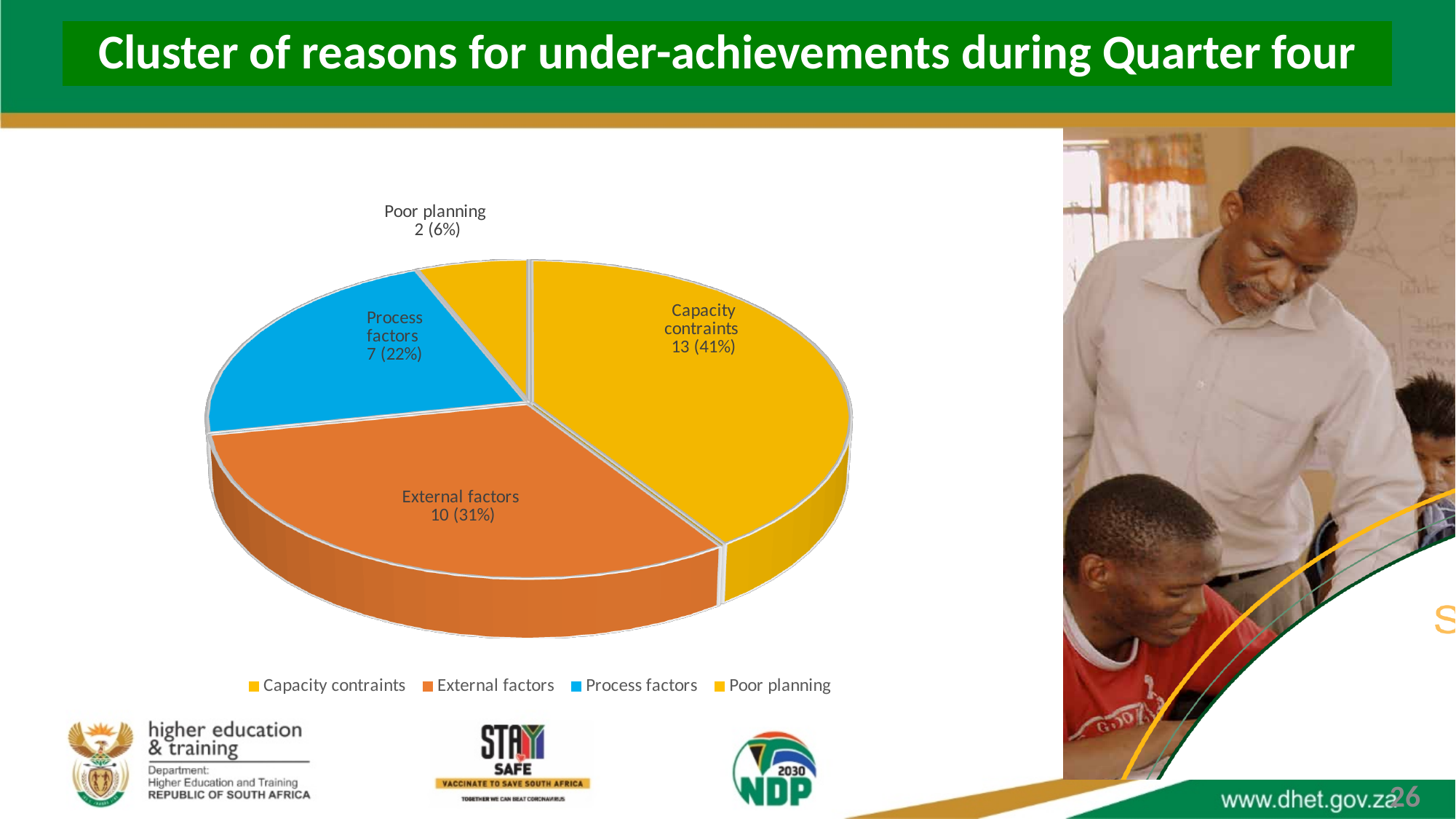
Which is larger, Process factors or External factors? External factors Which category has the largest slice? Capacity contraints How many slices does the pie chart have? 4 What is the count for External factors? 10 What is the count for Capacity contraints? 13 How many entries does the legend list? 4 What colour is the Process factors slice? Blue What percentage share does Process factors have? 22% What percentage share does Poor planning have? 6% What kind of chart is shown on the slide? Pie chart What is the difference in count between Capacity contraints and External factors? 3 Which category has the smallest slice? Poor planning